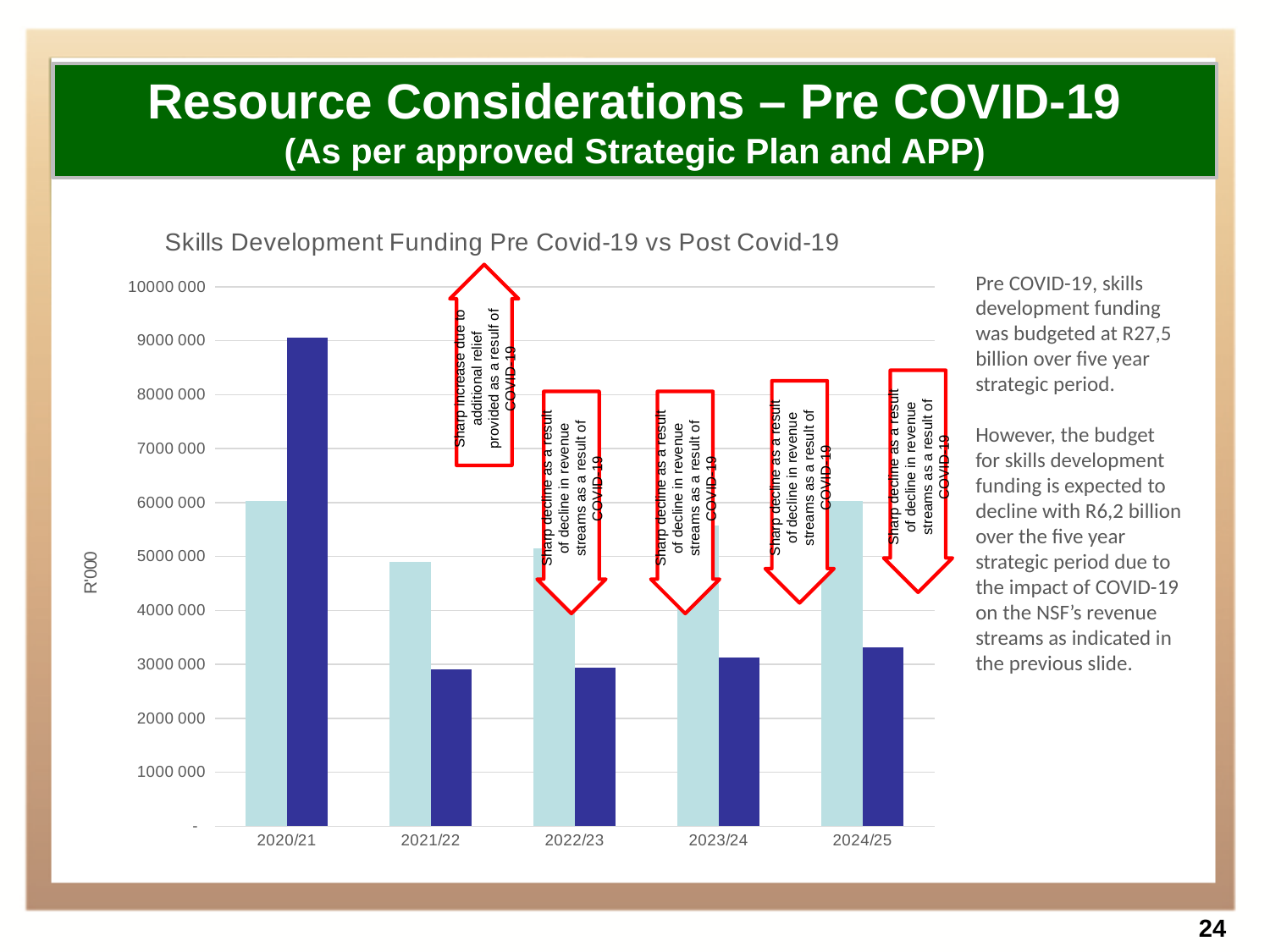
Do the dark blue bars rise or fall from 2021/22 to 2024/25? Rise How many financial years are shown on the x axis of the chart? 5 For 2020/21, which bar is larger, the light blue bar or the dark blue bar? Dark blue In which year is the dark blue bar the highest? 2020/21 Is the dark blue bar for 2021/22 greater or less than 4000 000? less For 2024/25, which bar is larger, the light blue bar or the dark blue bar? Light blue What is the label on the vertical axis of the chart? R'000 Is the dark blue bar for 2024/25 greater or less than 4000 000? less Is the light blue bar for 2021/22 greater or less than 6000 000? less What kind of chart is shown on the slide? Bar chart What is the title of the chart? Skills Development Funding Pre Covid-19 vs Post Covid-19